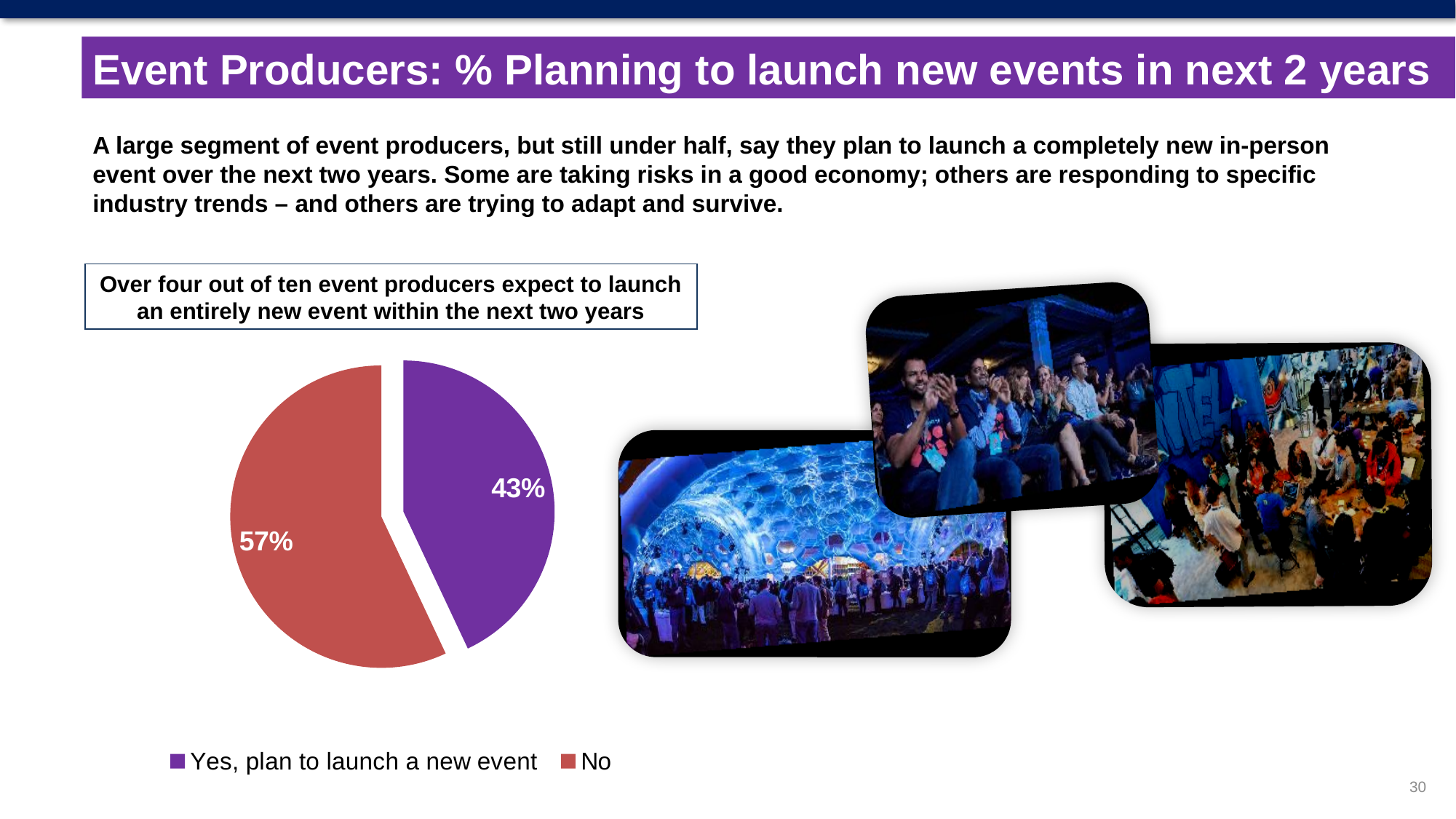
What percentage of event producers answered 'No'? 57% What percentage of event producers say 'Yes, plan to launch a new event'? 43% Is the share of event producers planning to launch a new event greater or less than 50%? less Which is larger: the share answering 'No' or the share answering 'Yes, plan to launch a new event'? No What colour is the 'Yes, plan to launch a new event' slice? Purple How many entries does the chart legend list? 2 Which slice of the pie chart is the largest? No What type of chart is shown on the slide? Pie chart What is the difference in percentage points between the 'No' slice and the 'Yes, plan to launch a new event' slice? 14 percentage points What share of the pie does the 'No' slice represent? 57% Which slice of the pie chart is the smallest? Yes, plan to launch a new event How many slices does the pie chart have? 2